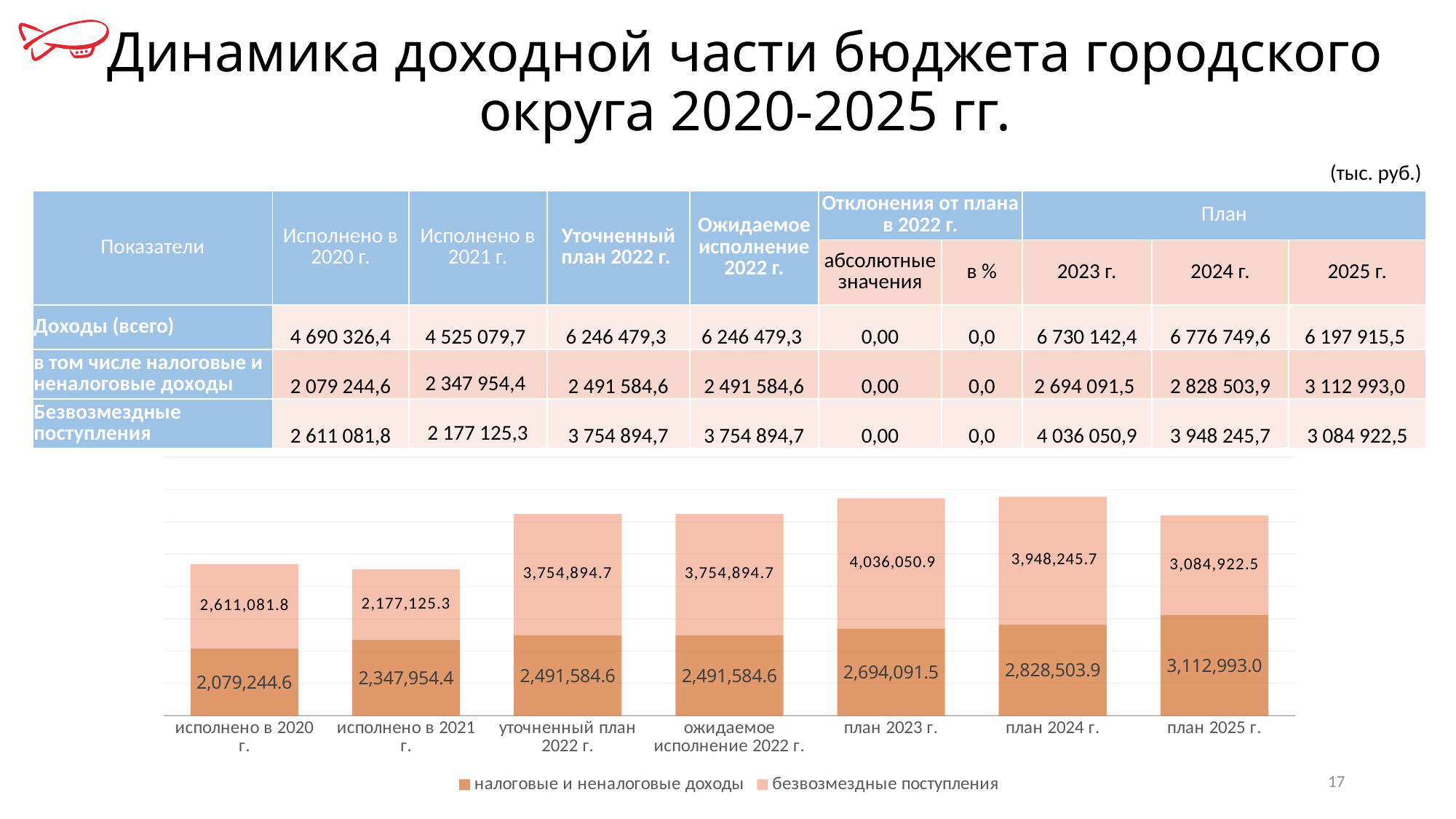
Which category has the lowest value for безвозмездные поступления? исполнено в 2021 г. Which category has the highest value for налоговые и неналоговые доходы? план 2025 г. What kind of chart is shown on the slide? stacked bar chart What is the value of налоговые и неналоговые доходы for исполнено в 2020 г.? 2,079,244.6 How many categories are shown on the x axis of the chart? 7 What is the value of безвозмездные поступления for план 2025 г.? 3,084,922.5 What is the value of безвозмездные поступления for план 2023 г.? 4,036,050.9 What is the total of the stacked bar for план 2025 г.? 6,197,915.5 For исполнено в 2020 г., which is larger: налоговые и неналоговые доходы or безвозмездные поступления? безвозмездные поступления How many series does the chart legend list? 2 Do the values for налоговые и неналоговые доходы rise or fall from исполнено в 2020 г. to план 2025 г.? rise What is the difference in налоговые и неналоговые доходы between исполнено в 2021 г. and исполнено в 2020 г.? 268,709.8